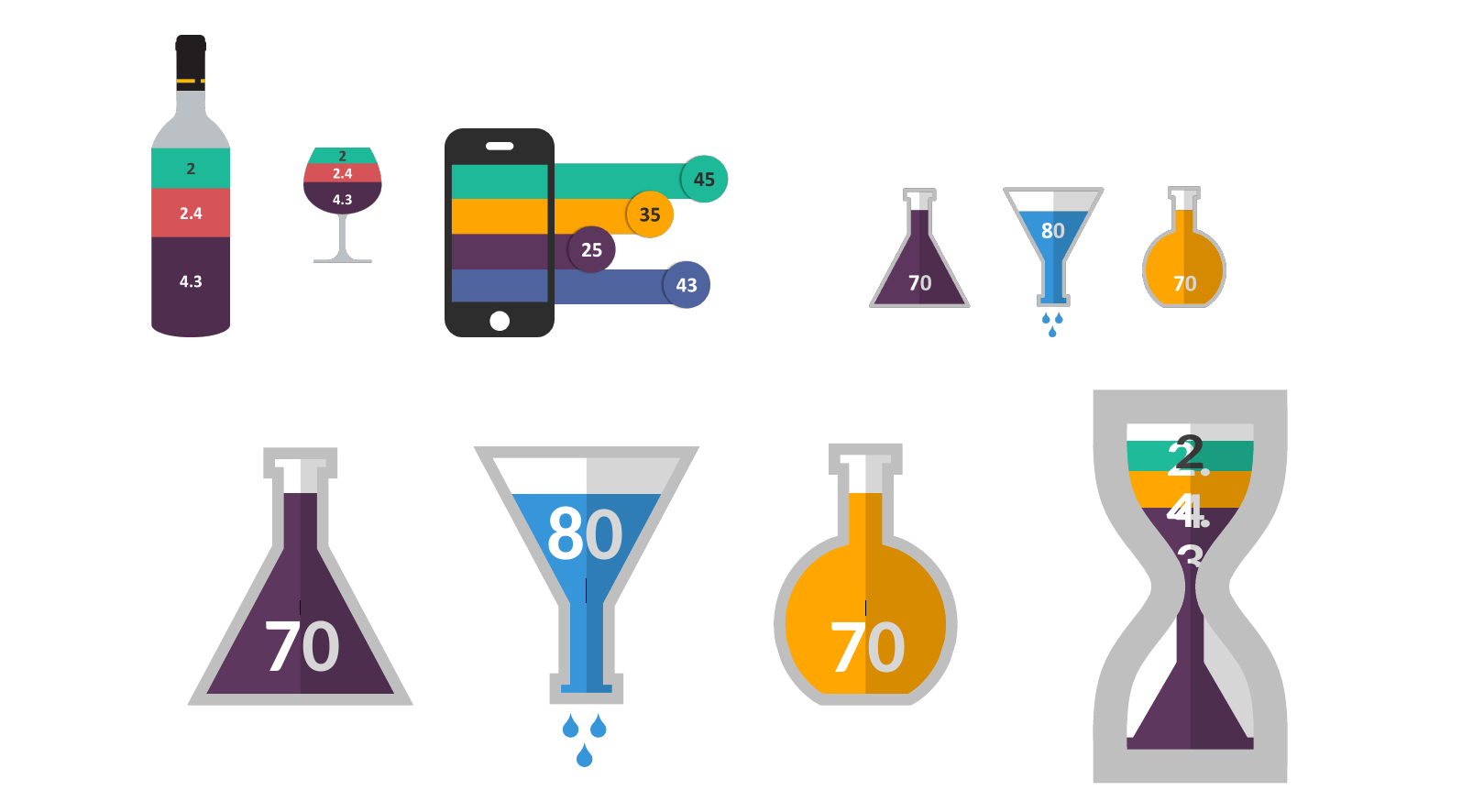
On the bar chart extending from the phone graphic, how many bars are there? 4 What value is printed on the large funnel graphic in the bottom row? 80 On the bar chart extending from the phone graphic, what value is shown on the orange bar? 35 What three values are printed on the segments of the wine bottle graphic, from top to bottom? 2, 2.4, 4.3 On the bar chart extending from the phone graphic, which is larger: the blue bar or the orange bar? The blue bar (43) On the bar chart extending from the phone graphic, what value is shown on the blue (bottom) bar? 43 On the bar chart extending from the phone graphic, what value is shown on the dark purple bar? 25 On the bar chart extending from the phone graphic, what is the difference between the teal bar and the orange bar? 10 On the bar chart extending from the phone graphic, which bar has the highest value? The teal (top) bar, 45 On the bar chart extending from the phone graphic, what value is shown on the teal (top) bar? 45 What kind of chart extends from the phone graphic? Bar chart On the bar chart extending from the phone graphic, which bar has the lowest value? The dark purple bar, 25